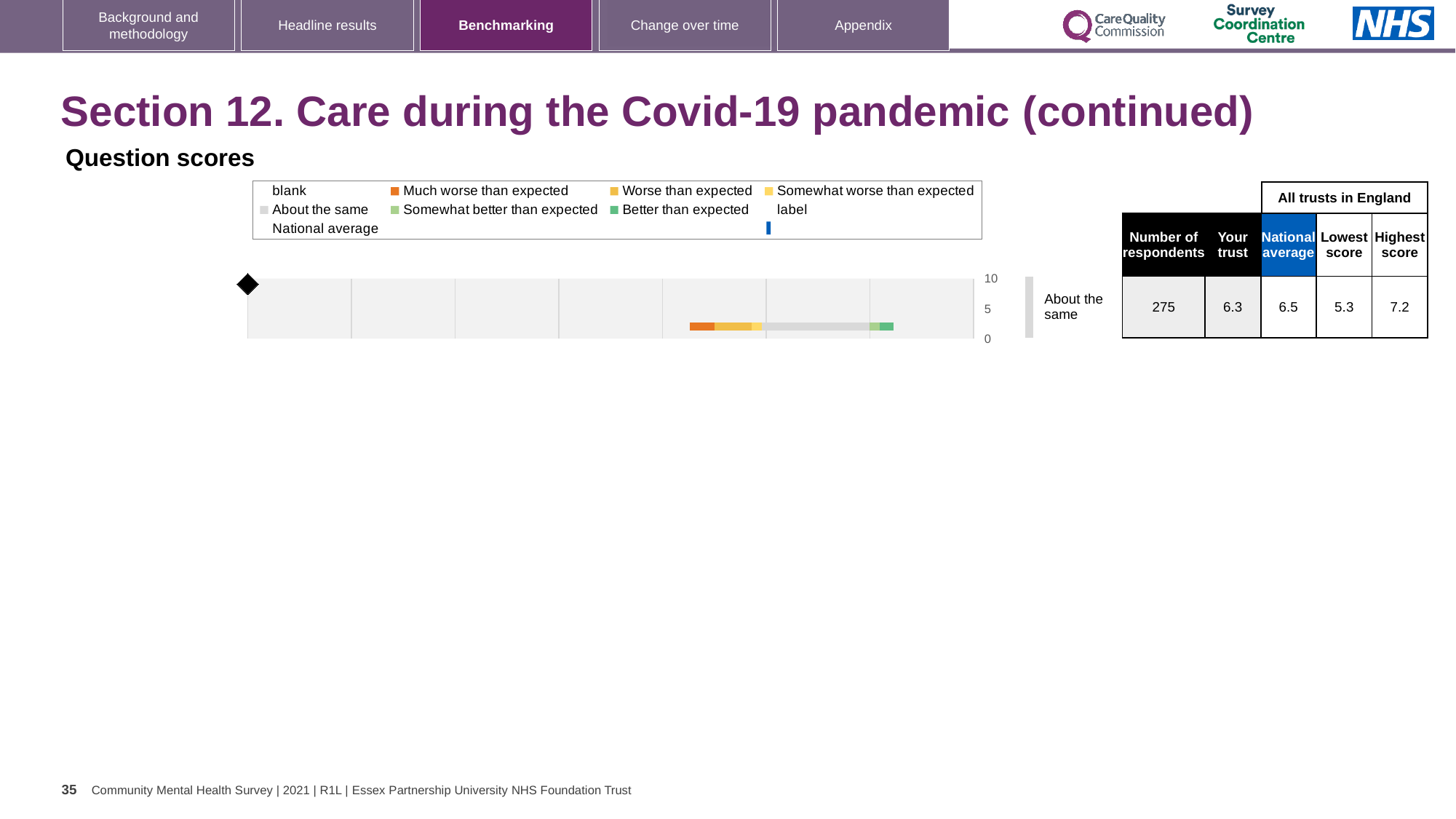
What is the difference between the highest score and the lowest score among all trusts in England? 1.9 How many question rows are plotted in the Question scores chart? 1 What is the benchmark category shown next to the bar in the Question scores chart? About the same In the table beside the chart, what is the national average score? 6.5 Which is larger, the 'Your trust' score or the national average score? National average In the table beside the chart, what is the score for 'Your trust'? 6.3 What is the highest value shown on the chart's numeric axis? 10 In the table beside the chart, what is the number of respondents? 275 In the table beside the chart, what is the lowest score among all trusts in England? 5.3 In the table beside the chart, what is the highest score among all trusts in England? 7.2 What kind of chart is shown under 'Question scores'? bar chart Which colour in the legend represents 'Much worse than expected'? orange